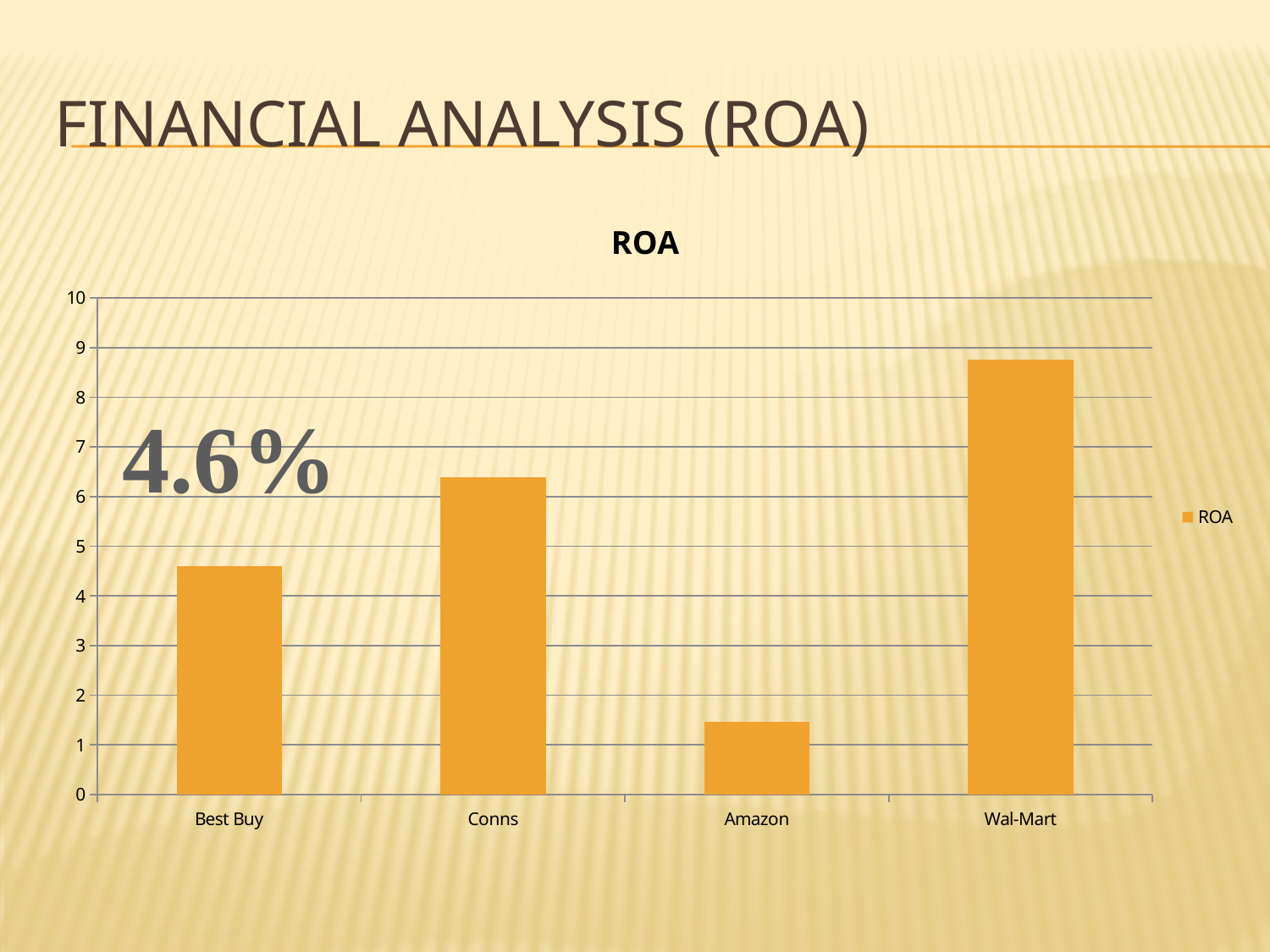
What large percentage value is printed in text over the chart area? 4.6% Which has a higher ROA, Amazon or Wal-Mart? Wal-Mart How many series does the legend of the ROA chart list? 1 How many companies are shown on the x axis of the ROA chart? 4 Is the ROA value for Wal-Mart greater or less than 8? greater What kind of chart is shown on the slide? bar chart Which company has the highest ROA in the chart? Wal-Mart What is the title of the chart? ROA Is the ROA value for Conns greater or less than 6? greater Which company has the lowest ROA in the chart? Amazon Is the ROA value for Amazon greater or less than 2? less Which has a higher ROA, Best Buy or Conns? Conns